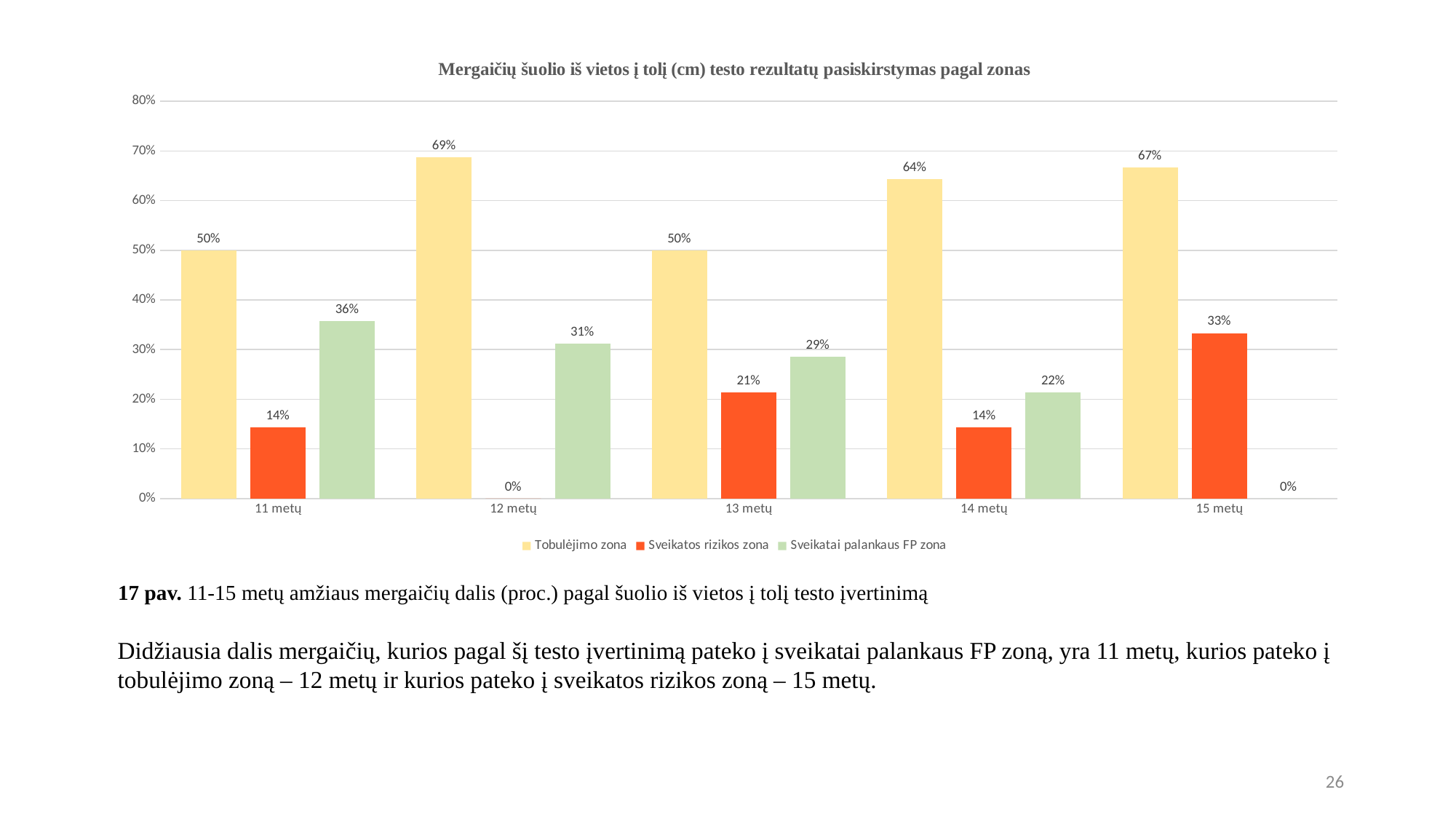
What is the value of Sveikatai palankaus FP zona for 11 metų? 36% What kind of chart is shown on the slide? Bar chart Which age group has the highest value for Tobulėjimo zona? 12 metų What is the value of Sveikatos rizikos zona for 12 metų? 0% What is the value of Tobulėjimo zona for 12 metų? 69% How many series does the legend list? 3 How many age groups are shown on the x axis? 5 What is the difference between Tobulėjimo zona and Sveikatai palankaus FP zona for 12 metų? 38 percentage points Which age group has the highest value for Sveikatos rizikos zona? 15 metų Which age group has the lowest value for Sveikatai palankaus FP zona? 15 metų Which is larger: Sveikatos rizikos zona for 13 metų or for 14 metų? 13 metų What is the value of Sveikatos rizikos zona for 15 metų? 33%